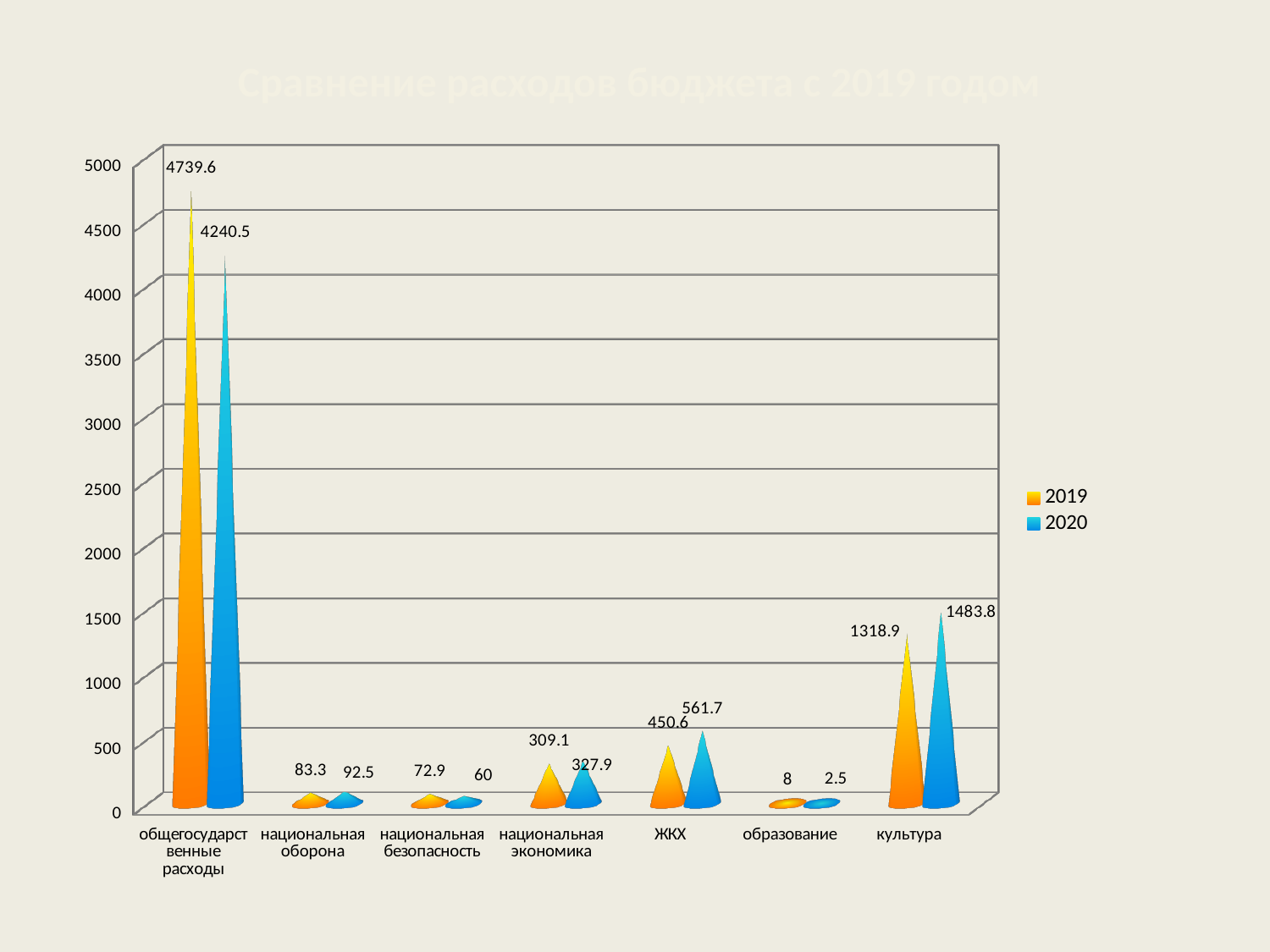
How many series does the legend list? 2 What is the 2020 value for национальная безопасность? 60 Which is larger for национальная экономика, the 2019 value or the 2020 value? 2020 Which category has the highest 2019 value? общегосударственные расходы What is the 2020 value for культура? 1483.8 How many categories are shown on the x axis? 7 What is the difference between the 2020 and 2019 values for культура? 164.9 What is the difference between the 2019 and 2020 values for общегосударственные расходы? 499.1 What is the 2019 value for общегосударственные расходы? 4739.6 What is the 2019 value for ЖКХ? 450.6 What kind of chart is shown on the slide? Bar chart Which category has the lowest 2020 value? образование